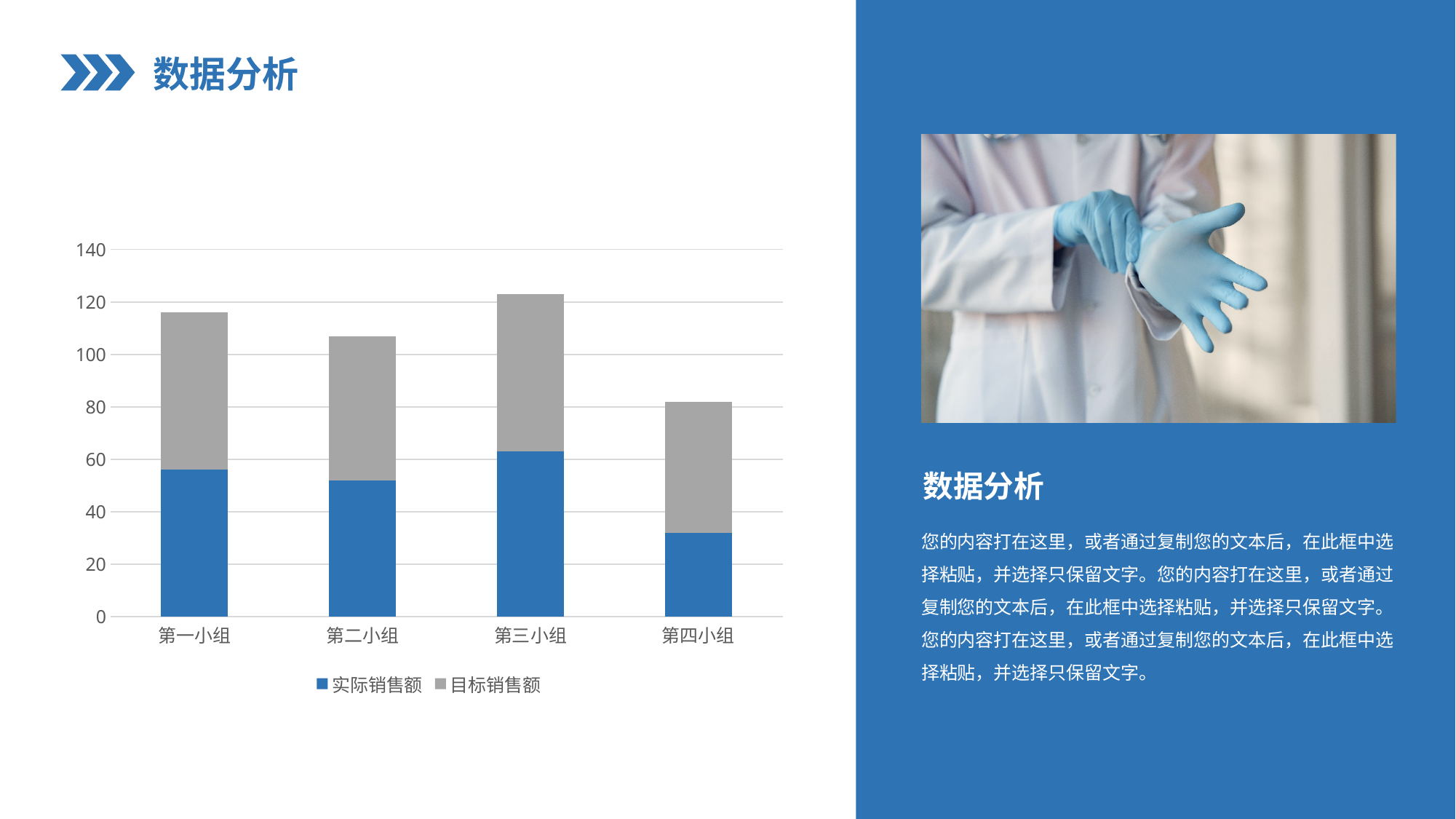
Is the 实际销售额 value for 第三小组 greater or less than 60? greater Is the total height of the stacked bar for 第四小组 greater or less than 100? less Which group has the lowest 实际销售额 (blue segment)? 第四小组 Which group has the highest 实际销售额 (blue segment)? 第三小组 How many series does the chart legend list? 2 Which has the taller stacked bar overall, 第一小组 or 第二小组? 第一小组 Which group has the shortest stacked bar overall? 第四小组 Which colour represents 目标销售额 in the chart legend? Gray Which group has the tallest stacked bar overall? 第三小组 What kind of chart is shown on the slide? Stacked bar chart How many categories (groups) are shown on the x axis of the chart? 4 Is the 实际销售额 value for 第四小组 greater or less than 40? less